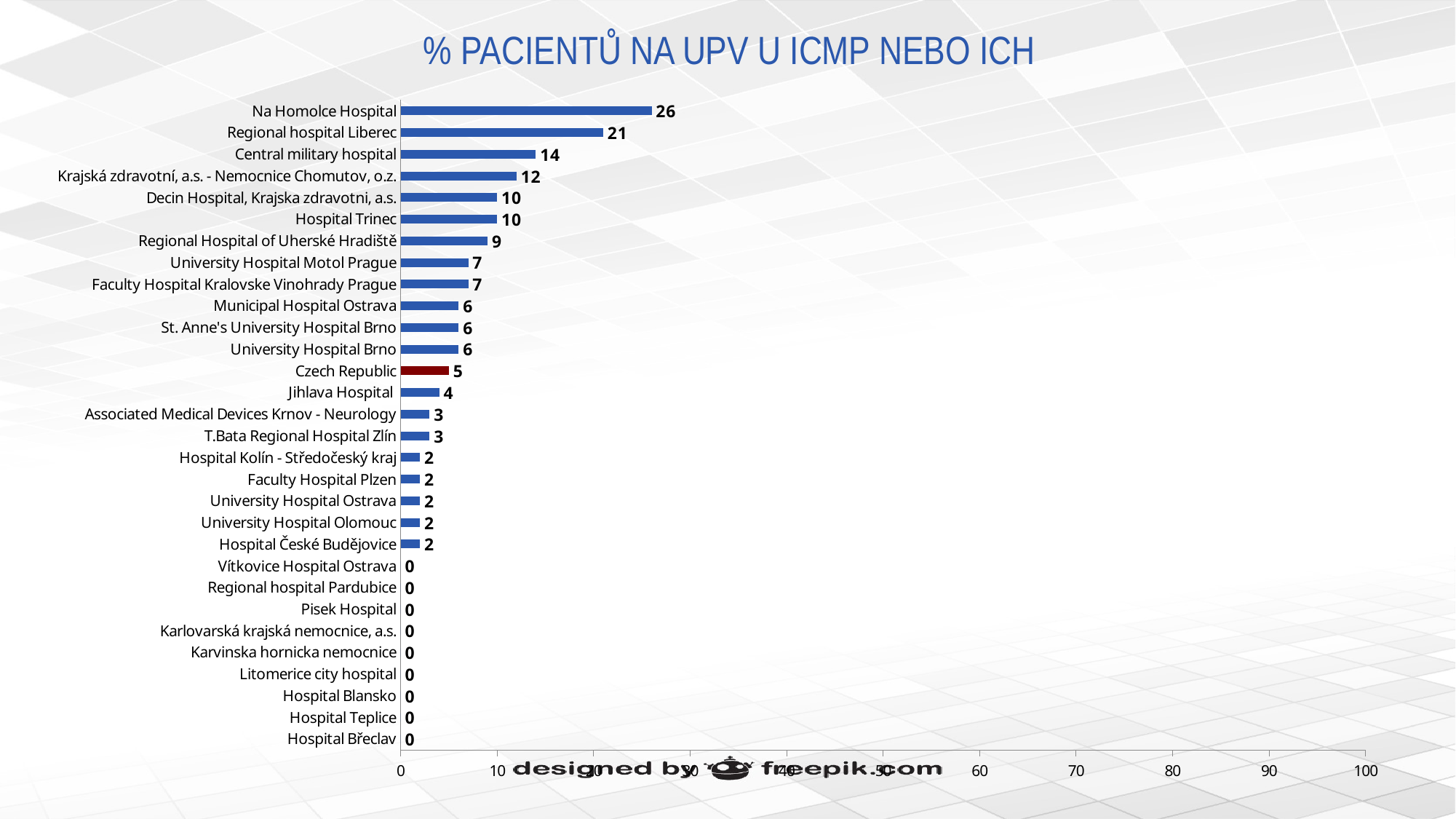
How many categories are shown on the chart? 30 What is the value for Czech Republic? 5 What is the difference between the values for Na Homolce Hospital and Regional hospital Liberec? 5 What kind of chart is shown on the slide? bar chart What is the value for Na Homolce Hospital? 26 What is the title of the chart? % PACIENTŮ NA UPV U ICMP NEBO ICH What is the value for Central military hospital? 14 Is the value for Regional hospital Liberec greater or less than 20? greater Which is larger, the value for University Hospital Motol Prague or the value for Municipal Hospital Ostrava? University Hospital Motol Prague Which category has the highest value? Na Homolce Hospital Which category's bar is coloured dark red instead of blue? Czech Republic What is the value for Jihlava Hospital? 4